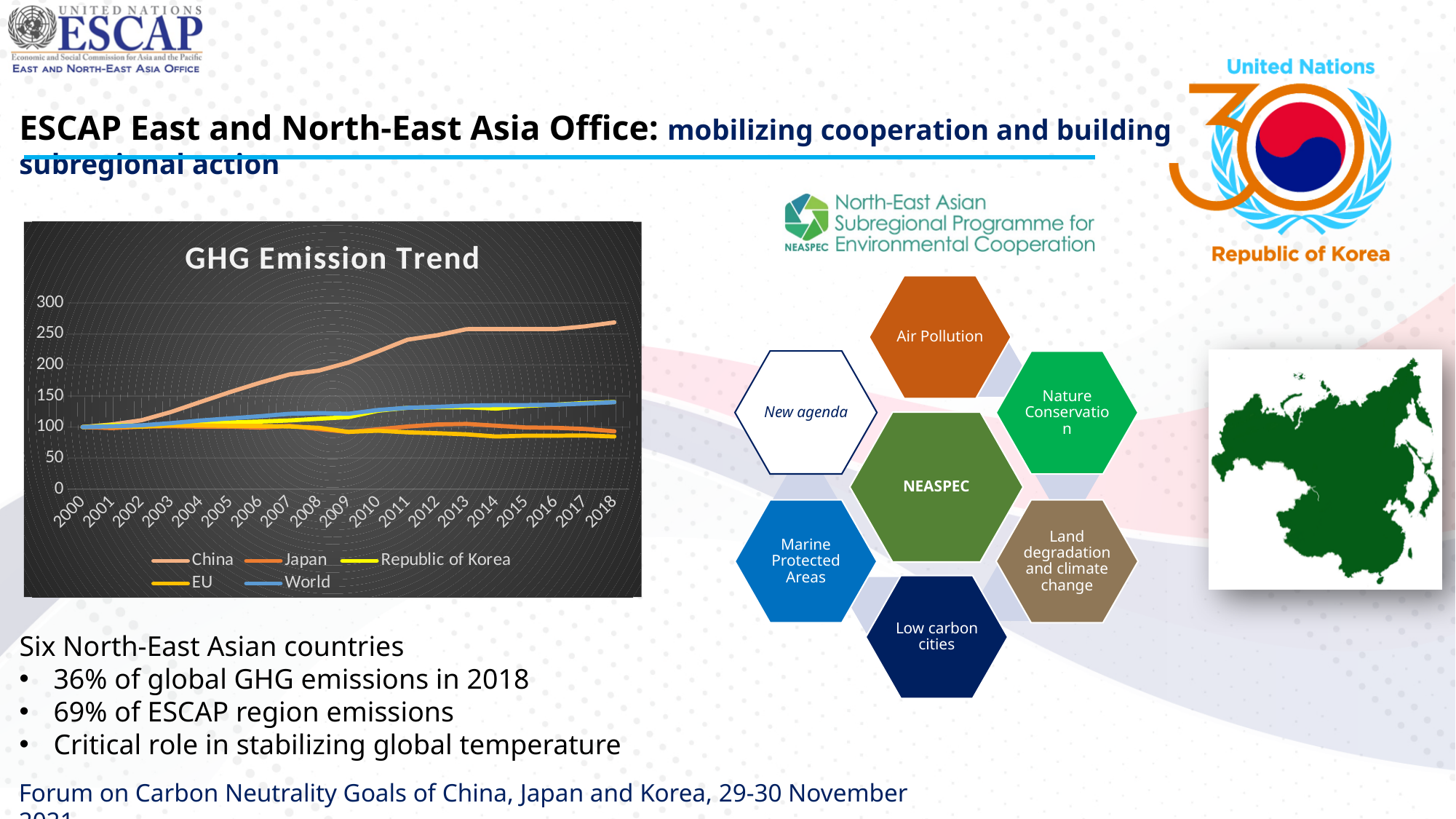
In the GHG Emission Trend chart, which is larger in 2018: China or Japan? China In the GHG Emission Trend chart, is the value for China in 2018 greater or less than 250? greater Does the EU series in the GHG Emission Trend chart rise or fall from 2000 to 2018? fall In the GHG Emission Trend chart, is the value for China in 2011 greater or less than 200? greater What is the title of the line chart on the slide? GHG Emission Trend How many series does the legend of the GHG Emission Trend chart list? 5 Does the China series in the GHG Emission Trend chart rise or fall from 2000 to 2018? rise In the GHG Emission Trend chart, is the value for EU in 2018 greater or less than 100? less What kind of chart is the GHG Emission Trend chart? line chart How many years are shown on the x axis of the GHG Emission Trend chart? 19 Which series has the highest value in 2018 in the GHG Emission Trend chart? China